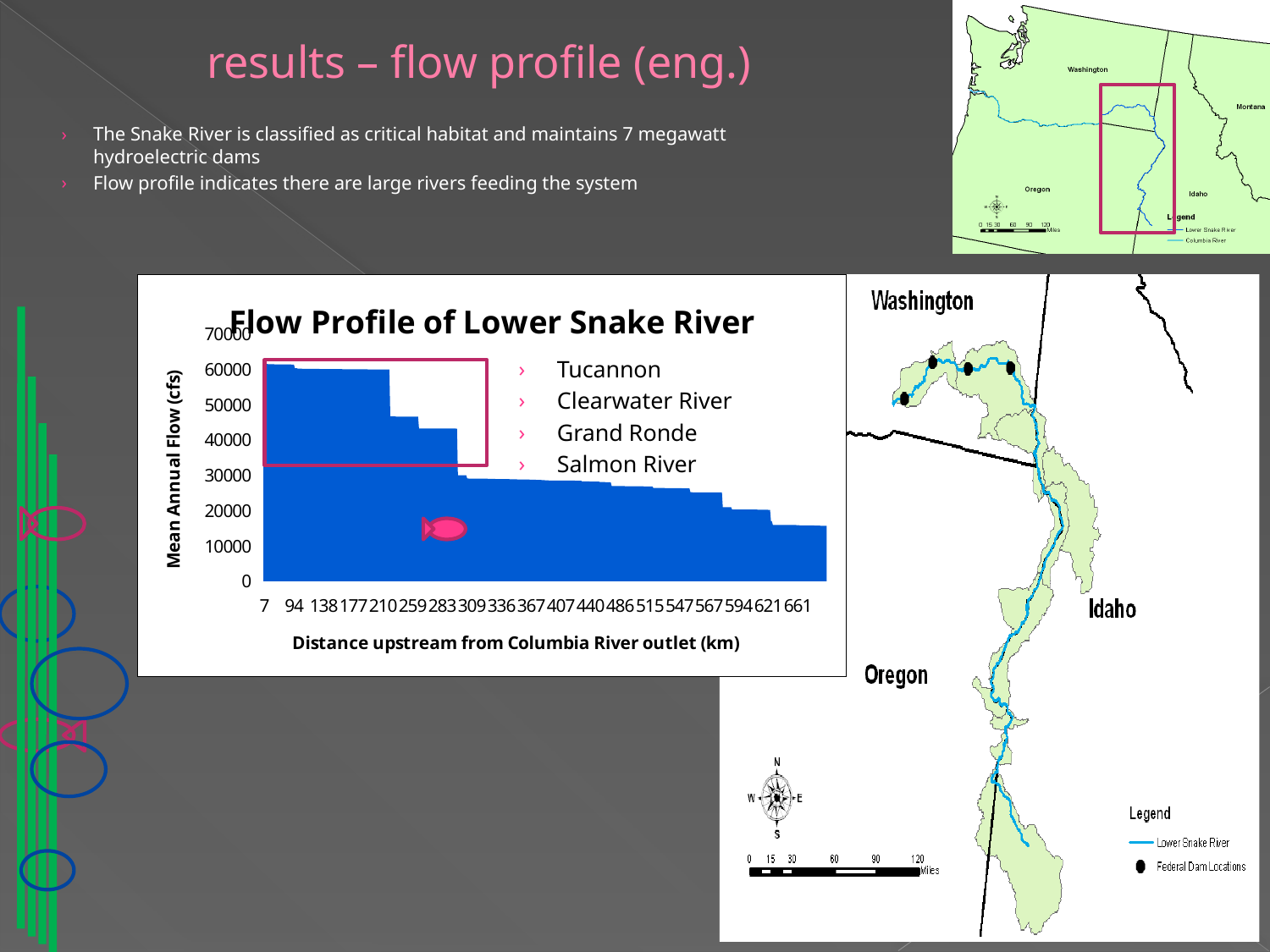
What is the highest value shown on the vertical axis of the Flow Profile of Lower Snake River chart? 70000 On the Flow Profile of Lower Snake River chart, which has the larger mean annual flow: 94 km or 594 km upstream? 94 km At which distance upstream is the mean annual flow lowest on the Flow Profile of Lower Snake River chart? 661 On the Flow Profile of Lower Snake River chart, is the mean annual flow at 407 km greater or less than 40000? less What is the title of the chart on the slide? Flow Profile of Lower Snake River What is the label of the vertical axis on the Flow Profile of Lower Snake River chart? Mean Annual Flow (cfs) On the Flow Profile of Lower Snake River chart, is the mean annual flow at 7 km greater or less than 50000? greater Do the values on the Flow Profile of Lower Snake River chart rise or fall as distance upstream increases? fall What kind of chart is the Flow Profile of Lower Snake River chart? area chart How many distance values are labelled on the x axis of the Flow Profile of Lower Snake River chart? 19 On the Flow Profile of Lower Snake River chart, is the mean annual flow at 661 km greater or less than 20000? less